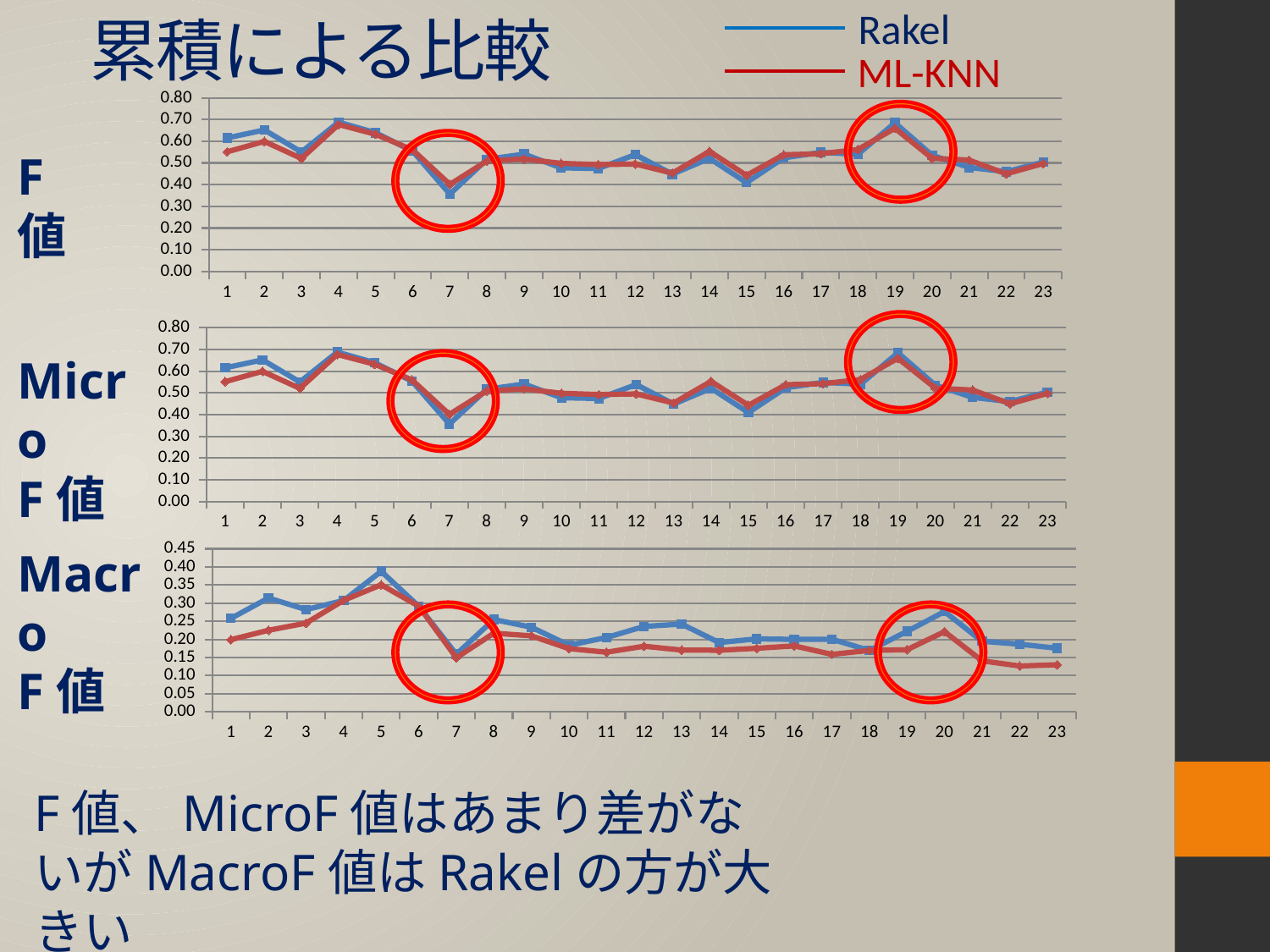
In the top F値 chart, at which x-axis point is the Rakel series lowest? 7 How many points are plotted along the x axis of the MacroF値 chart at the bottom? 23 In the bottom MacroF値 chart, at which x-axis point is the Rakel series highest? 5 In the top F値 chart, is the Rakel value at point 7 greater or less than 0.40? less In the bottom MacroF値 chart, is the Rakel value at point 5 greater or less than 0.35? greater What kind of chart is the top chart labelled F値? line chart How many series does the legend list for the charts on this slide? 2 In the middle MicroF値 chart, is the ML-KNN value at point 2 greater or less than 0.50? greater In the bottom MacroF値 chart, which series has the larger value at point 20, Rakel or ML-KNN? Rakel Which colour represents the ML-KNN series in the legend? red